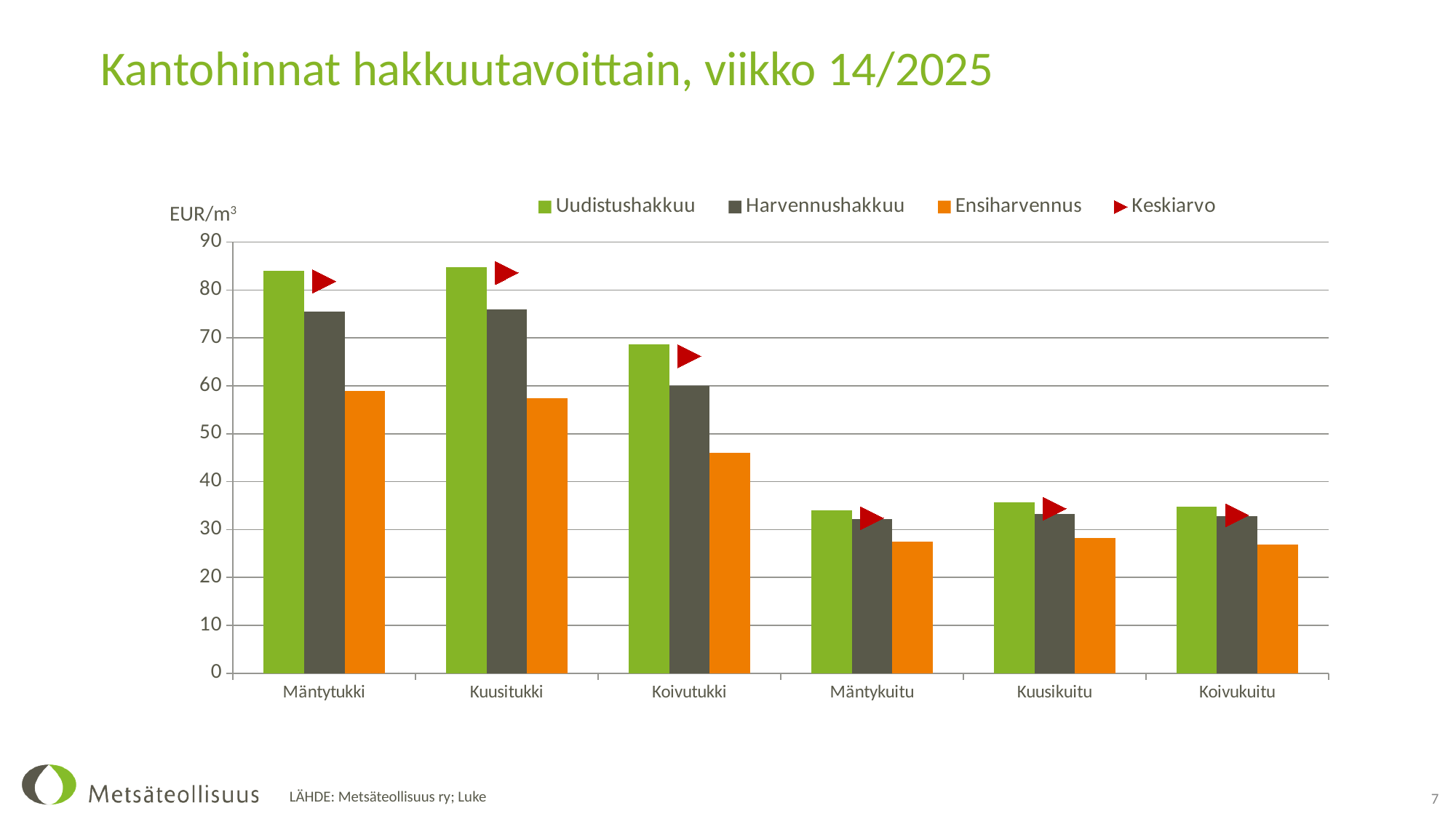
Is the Ensiharvennus value for Mäntykuitu greater or less than 30? less How many categories are shown on the x axis? 6 Is the Uudistushakkuu value for Kuusikuitu greater or less than 30? greater Is the Harvennushakkuu value for Kuusitukki greater or less than 70? greater Which is larger for Mäntytukki, the Uudistushakkuu value or the Ensiharvennus value? Uudistushakkuu What kind of chart is shown on the slide? bar chart What unit is shown on the vertical axis? EUR/m³ Which is larger, the Uudistushakkuu value for Mäntytukki or for Koivutukki? Mäntytukki How many series does the legend list? 4 Which colour represents the Ensiharvennus series? orange